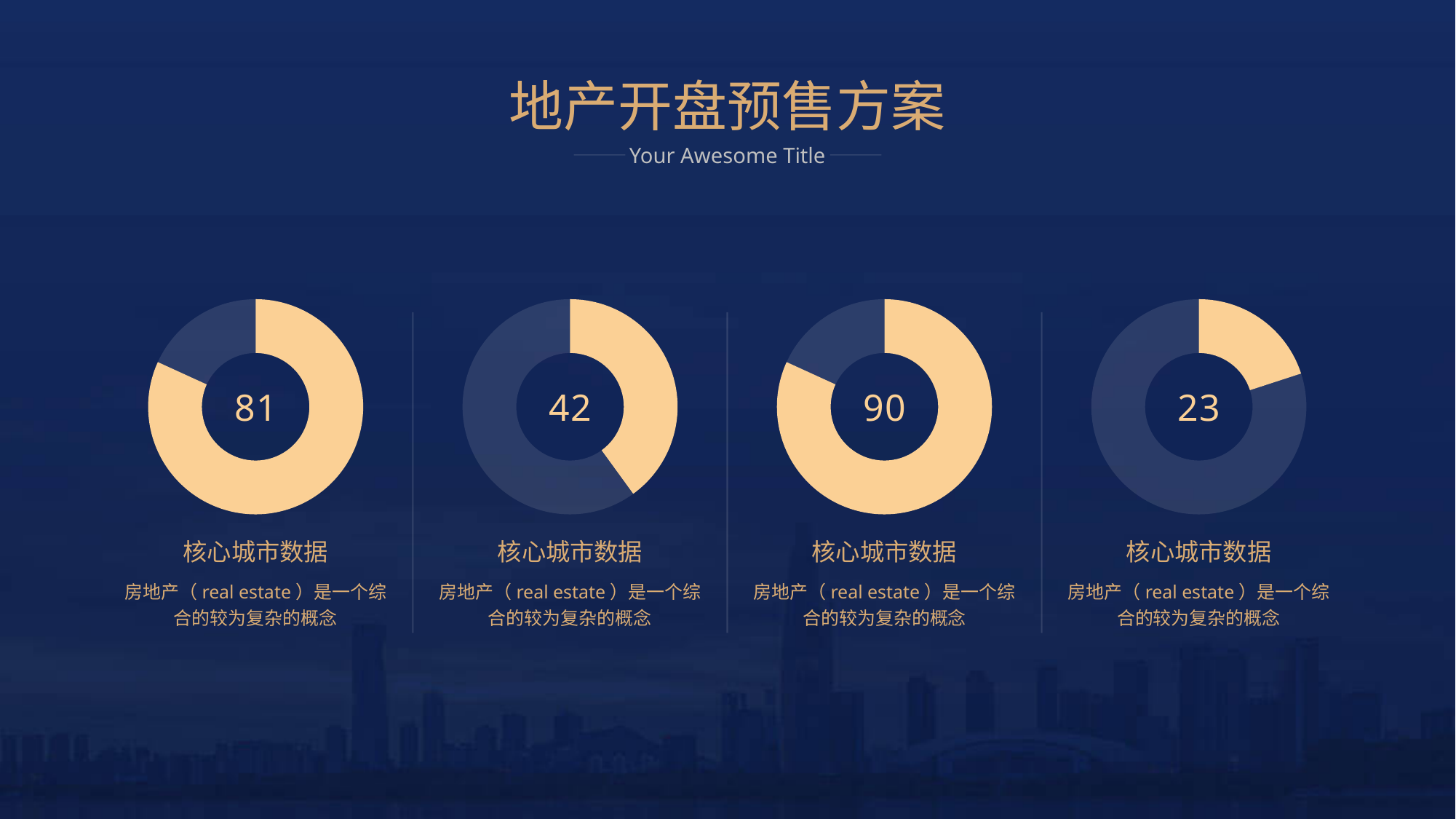
Which of the four donut charts shows the lowest value? The rightmost (23) What is the difference between the value in the third donut chart (90) and the value in the rightmost donut chart (23)? 67 What is the difference between the value in the leftmost donut chart (81) and the value in the second donut chart (42)? 39 Which of the four donut charts shows the highest value? The third from the left (90) How many donut charts are shown on the slide? 4 What value is shown in the center of the leftmost donut chart? 81 What value is shown in the center of the rightmost donut chart? 23 What kind of chart is used to display the four values on this slide? Donut chart What value is shown in the center of the second donut chart from the left? 42 What value is shown in the center of the third donut chart from the left? 90 What colour is the filled portion of each donut chart? Light orange/gold Which is larger: the value in the leftmost donut chart or the value in the second donut chart from the left? The leftmost (81)